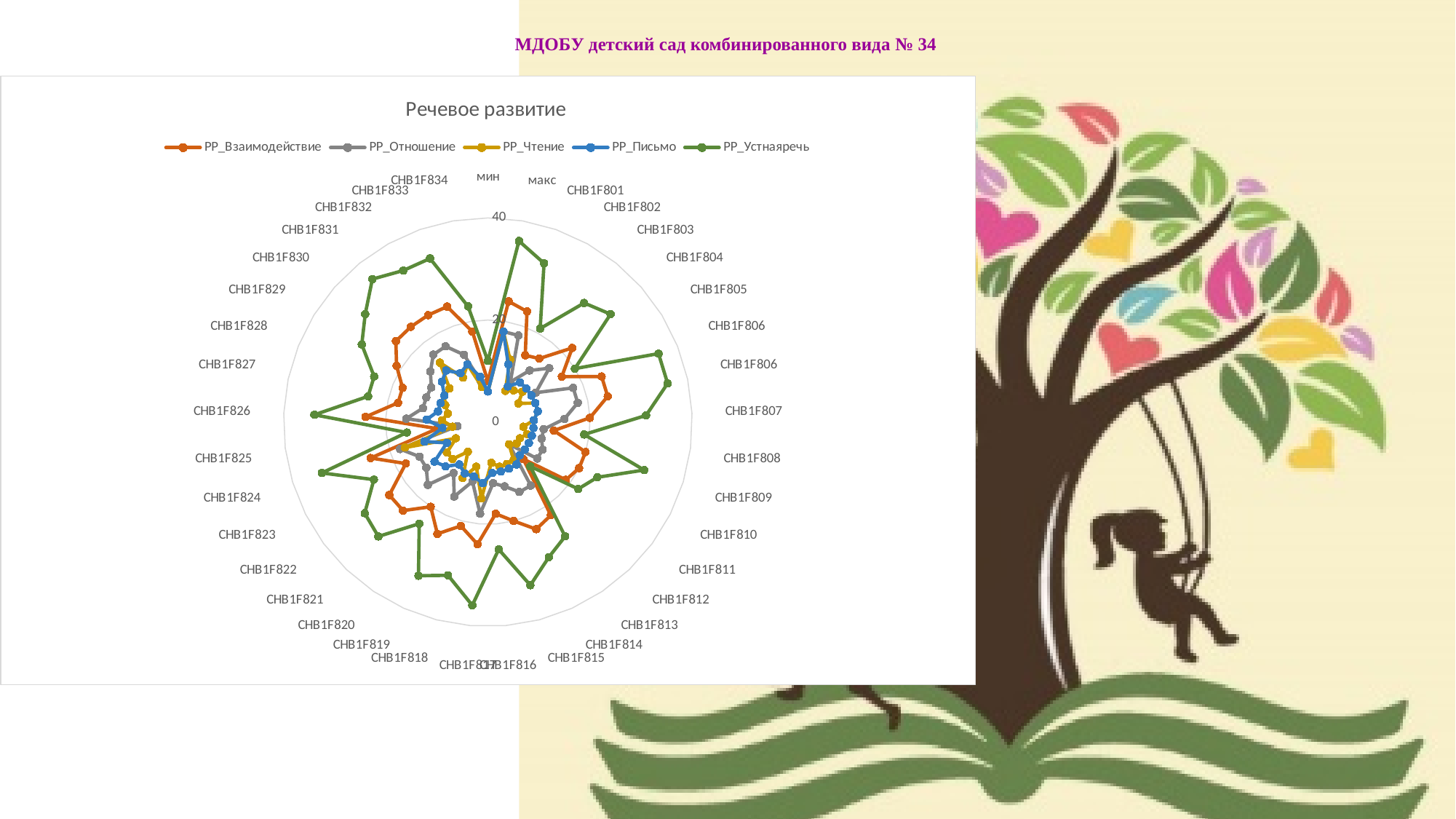
How many series does the legend of the chart list? 5 Is the value of РР_Письмо for CHB1F826 greater or less than 20? less What is the title of the chart? Речевое развитие Is the value of РР_Устнаяречь for CHB1F806 greater or less than 20? greater Which series is drawn in green on the chart? РР_Устнаяречь Which series has the highest value for CHB1F826? РР_Устнаяречь For CHB1F812, which series has the larger value: РР_Взаимодействие or РР_Чтение? РР_Взаимодействие What kind of chart is shown on the slide? radar chart Is the value of РР_Чтение for CHB1F801 greater or less than 20? less For CHB1F806, which series has the larger value: РР_Устнаяречь or РР_Письмо? РР_Устнаяречь